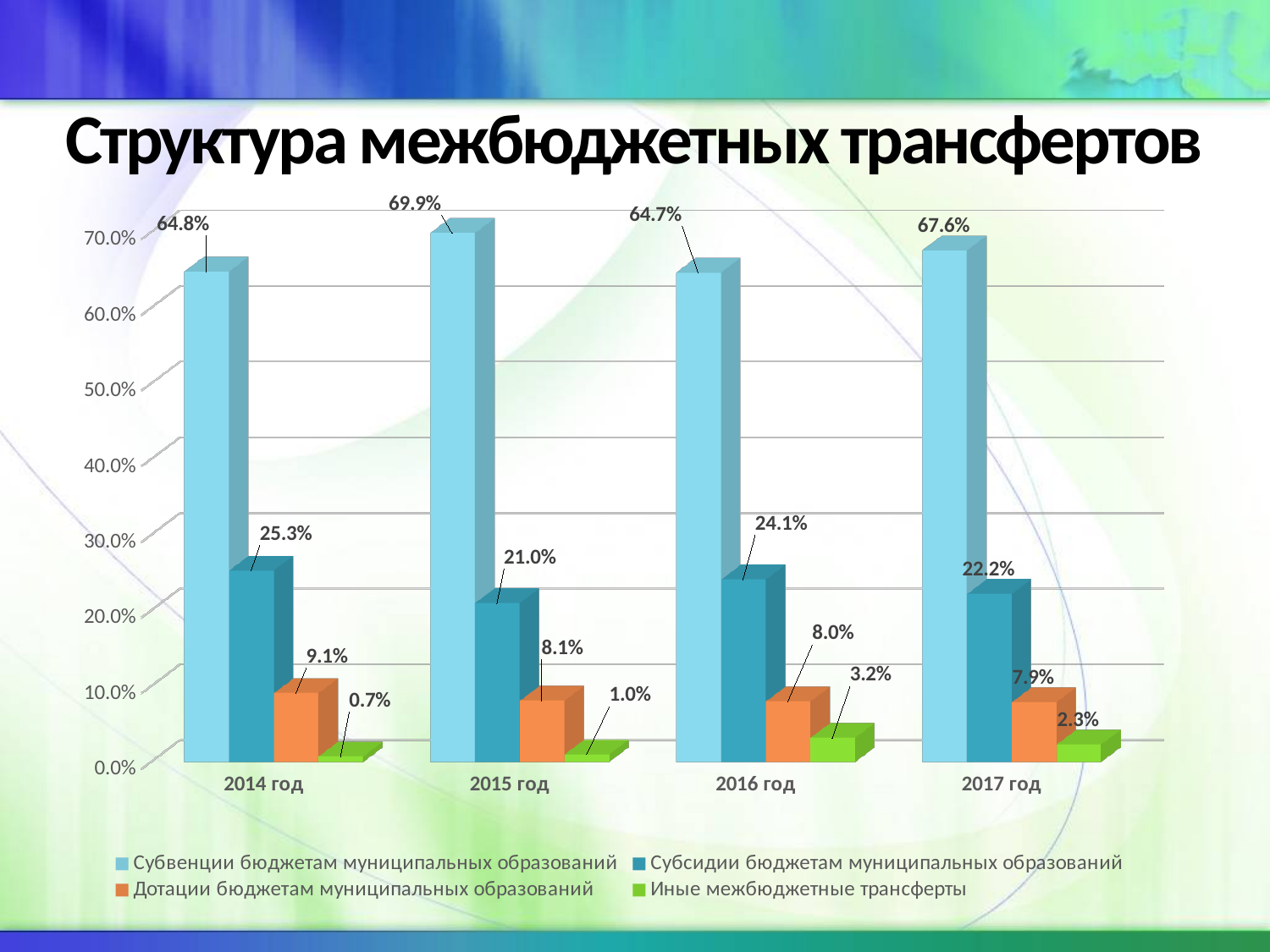
What is the value for Субвенции бюджетам муниципальных образований in 2015 год? 69.9% In which year is the value for Субвенции бюджетам муниципальных образований highest? 2015 год What is the title of the slide? Структура межбюджетных трансфертов What kind of chart is shown on the slide? Bar chart What is the value for Субсидии бюджетам муниципальных образований in 2016 год? 24.1% What is the value for Иные межбюджетные трансферты in 2017 год? 2.3% What is the difference between the Субсидии бюджетам муниципальных образований values for 2014 год and 2015 год? 4.3% How many series does the legend list? 4 How many years are shown on the x axis? 4 In which year is the value for Иные межбюджетные трансферты lowest? 2014 год Which is larger: Дотации бюджетам муниципальных образований in 2015 год or in 2016 год? 2015 год What is the value for Дотации бюджетам муниципальных образований in 2014 год? 9.1%